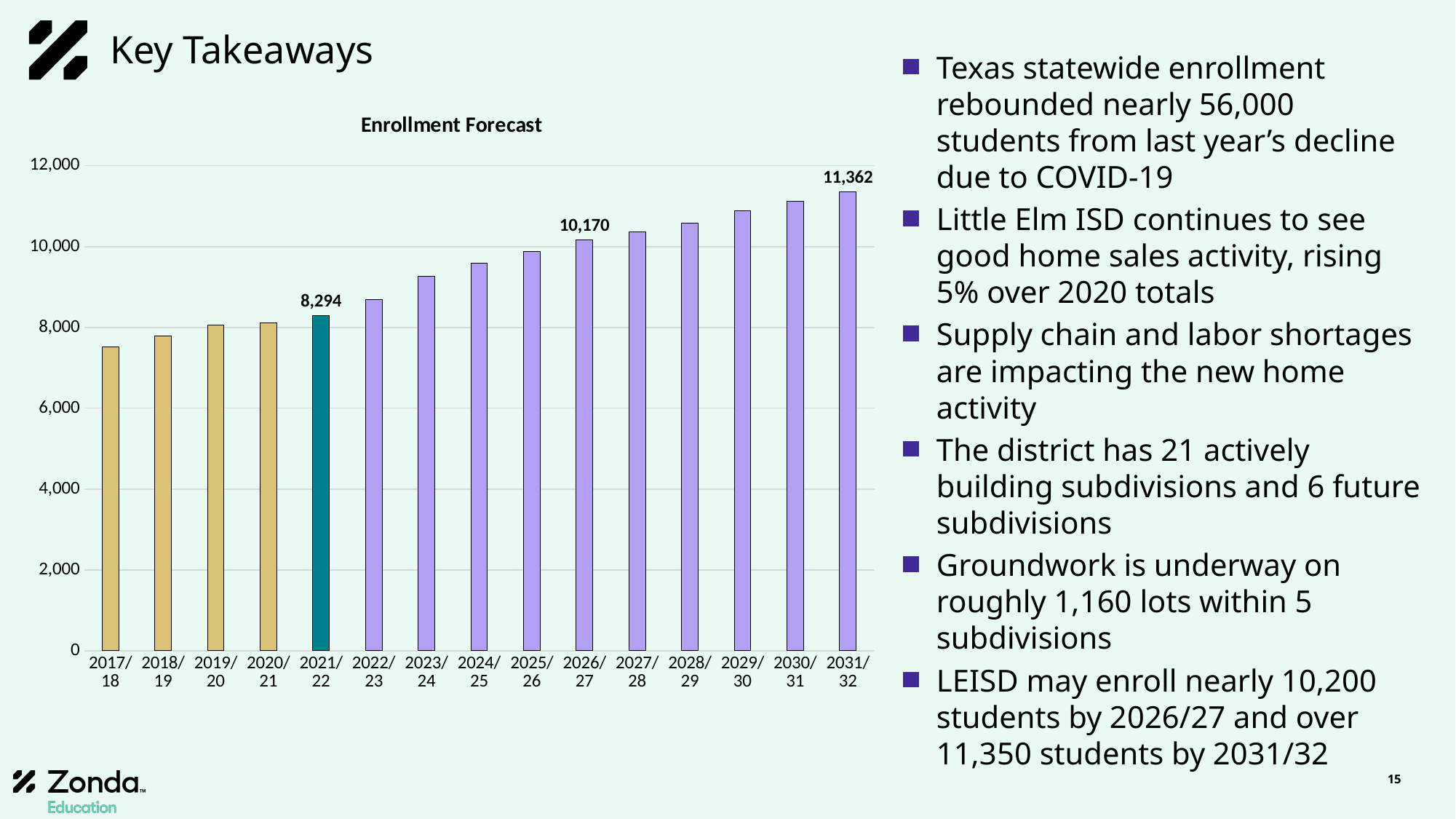
What is the enrollment value shown for 2021/22 in the Enrollment Forecast chart? 8,294 Do the enrollment values rise or fall from 2017/18 to 2031/32 in the Enrollment Forecast chart? rise How many school years are shown on the x axis of the Enrollment Forecast chart? 15 What is the difference between the 2031/32 and 2021/22 enrollment values in the Enrollment Forecast chart? 3,068 What is the difference between the 2026/27 and 2021/22 enrollment values in the Enrollment Forecast chart? 1,876 Which year has the lowest enrollment in the Enrollment Forecast chart? 2017/18 Is the enrollment value for 2029/30 greater or less than 10,000? greater Which year has the highest enrollment in the Enrollment Forecast chart? 2031/32 Is the enrollment value for 2017/18 greater or less than 8,000? less What is the enrollment value shown for 2031/32 in the Enrollment Forecast chart? 11,362 What is the enrollment value shown for 2026/27 in the Enrollment Forecast chart? 10,170 What kind of chart is the Enrollment Forecast? bar chart